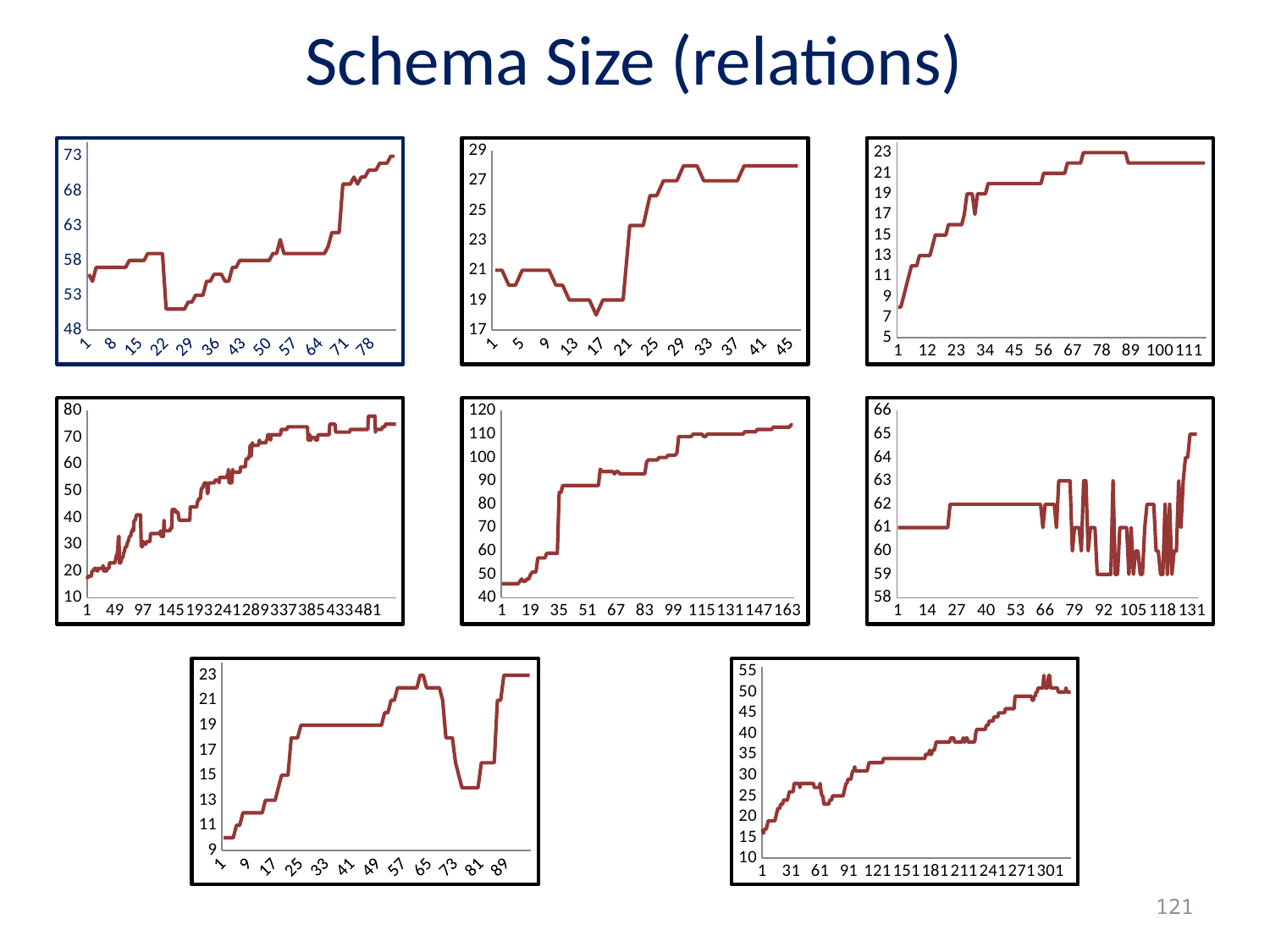
In the top-left chart, is the value at x = 1 greater or less than 58? less In the bottom-right chart, do the values generally rise or fall from left to right along the x axis? rise In the top-left chart, is the value at the right end of the line (x = 78 and beyond) greater or less than 68? greater In the top-right chart, do the values generally rise or fall from left to right along the x axis? rise In the middle-right chart, is the value at x = 1 greater or less than 62? less How many charts are shown on the slide? 8 What kind of chart is the top-left chart on the slide? line chart What is the title of the slide above the charts? Schema Size (relations)